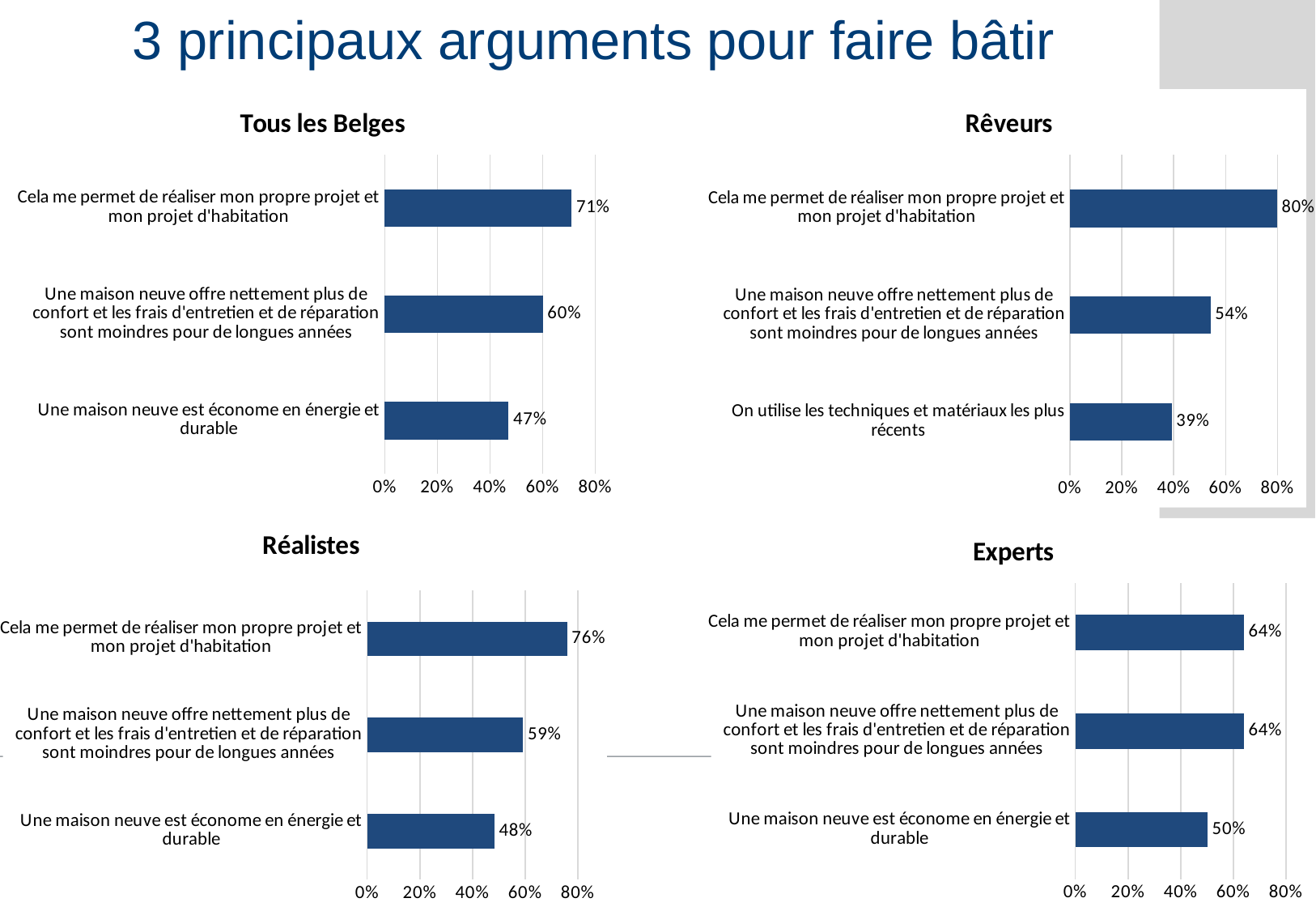
In the 'Réalistes' chart, what is the difference between the values for 'Cela me permet de réaliser mon propre projet et mon projet d'habitation' and 'Une maison neuve est économe en énergie et durable'? 28% In the 'Rêveurs' chart, what is the difference between the values for 'Cela me permet de réaliser mon propre projet et mon projet d'habitation' and 'Une maison neuve offre nettement plus de confort et les frais d'entretien et de réparation sont moindres pour de longues années'? 26% In the 'Tous les Belges' chart, what is the value for 'Cela me permet de réaliser mon propre projet et mon projet d'habitation'? 71% In the 'Experts' chart, is the value for 'Une maison neuve est économe en énergie et durable' greater or less than 60%? less In the 'Tous les Belges' chart, which category has the lowest value? Une maison neuve est économe en énergie et durable In the 'Réalistes' chart, what is the value for 'Une maison neuve est économe en énergie et durable'? 48% In the 'Rêveurs' chart, which category has the highest value? Cela me permet de réaliser mon propre projet et mon projet d'habitation What type of chart is the 'Experts' chart? bar chart In the 'Rêveurs' chart, what is the value for 'On utilise les techniques et matériaux les plus récents'? 39% How many categories are shown in the 'Tous les Belges' chart? 3 In the 'Experts' chart, what is the value for 'Une maison neuve est économe en énergie et durable'? 50% Which is larger: the value for 'Cela me permet de réaliser mon propre projet et mon projet d'habitation' in the 'Réalistes' chart or in the 'Experts' chart? Réalistes